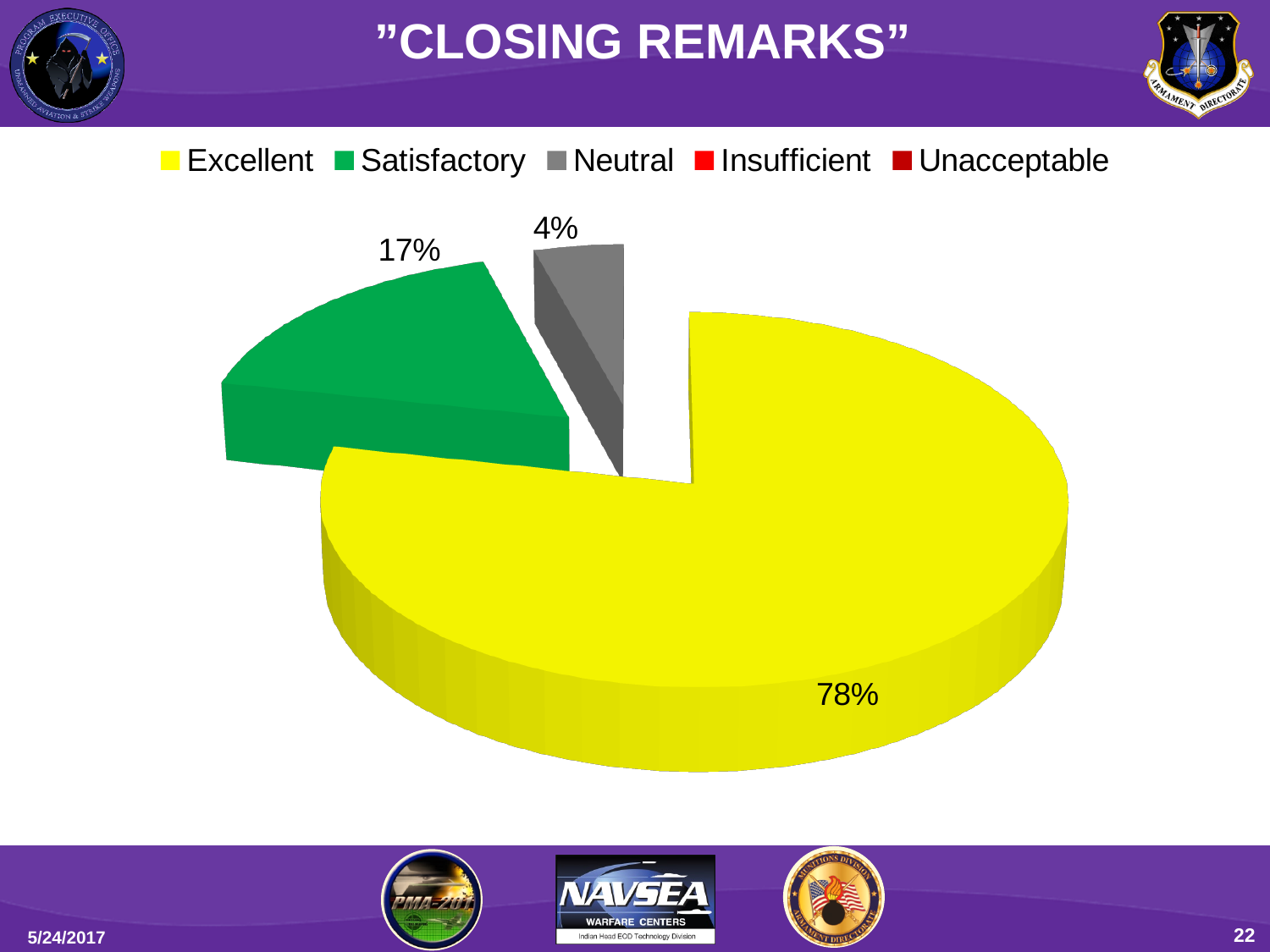
What kind of chart is shown on the slide? Pie chart How many slices with percentage labels are visible in the pie chart? 3 What percentage of the pie chart is labelled Neutral? 4% Of the slices shown with labels, which category has the smallest share? Neutral What is the difference in percentage points between the Satisfactory and Neutral slices? 13 Which category has the largest slice of the pie chart? Excellent What percentage of the pie chart is labelled Satisfactory? 17% What percentage of the pie chart is labelled Excellent? 78% Which slice is larger, Satisfactory or Neutral? Satisfactory What colour represents the Excellent category in the pie chart? Yellow How many entries does the legend of the pie chart list? 5 What is the difference in percentage points between the Excellent and Satisfactory slices? 61